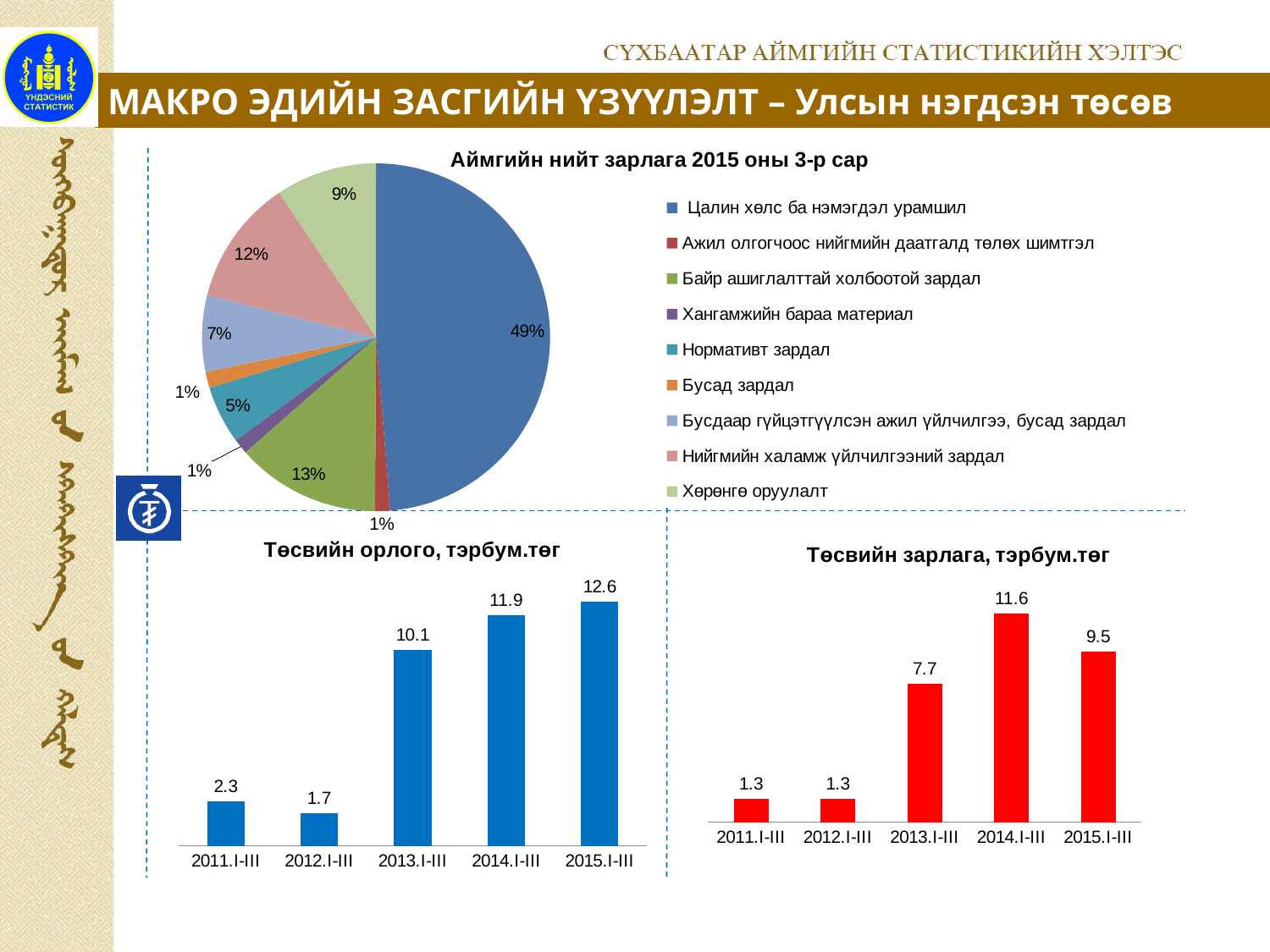
In the chart 'Төсвийн орлого, тэрбум.төг', what is the value for 2013.I-III? 10.1 In the chart 'Төсвийн орлого, тэрбум.төг', which period has the lowest value? 2012.I-III In the chart 'Төсвийн орлого, тэрбум.төг', what is the difference between the values for 2015.I-III and 2014.I-III? 0.7 What kind of chart is 'Төсвийн орлого, тэрбум.төг'? Bar chart In the chart 'Төсвийн зарлага, тэрбум.төг', which period has the highest value? 2014.I-III In the pie chart 'Аймгийн нийт зарлага 2015 оны 3-р сар', what share does 'Нийгмийн халамж үйлчилгээний зардал' have? 12% How many periods are shown on the x axis of the chart 'Төсвийн зарлага, тэрбум.төг'? 5 How many categories does the legend of the pie chart 'Аймгийн нийт зарлага 2015 оны 3-р сар' list? 9 In the chart 'Төсвийн зарлага, тэрбум.төг', what is the value for 2014.I-III? 11.6 In the pie chart 'Аймгийн нийт зарлага 2015 оны 3-р сар', what share does 'Цалин хөлс ба нэмэгдэл урамшил' have? 49% In the pie chart 'Аймгийн нийт зарлага 2015 оны 3-р сар', which category has the largest share? Цалин хөлс ба нэмэгдэл урамшил In the chart 'Төсвийн зарлага, тэрбум.төг', is the value for 2013.I-III larger or smaller than the value for 2015.I-III? Smaller